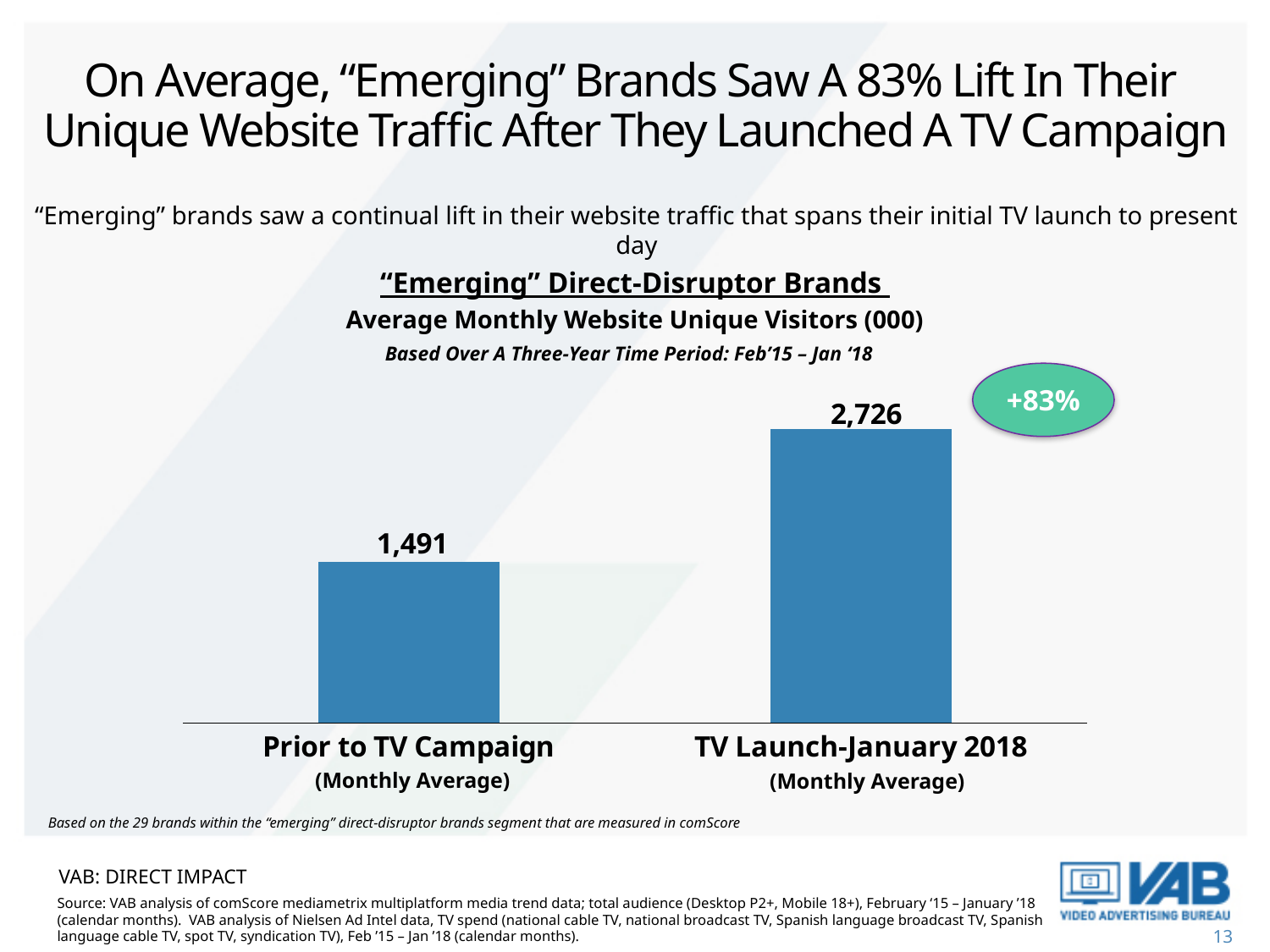
What is the difference between the TV Launch-January 2018 value and the Prior to TV Campaign value? 1,235 What is the average monthly website unique visitors (000) value for TV Launch-January 2018? 2,726 What is the average monthly website unique visitors (000) value for Prior to TV Campaign? 1,491 Do the values rise or fall from Prior to TV Campaign to TV Launch-January 2018? Rise What time period does the chart subtitle say the data is based over? Feb'15 – Jan '18 What kind of chart is shown on the slide? Bar chart Which category has the higher value, Prior to TV Campaign or TV Launch-January 2018? TV Launch-January 2018 What percentage lift is shown in the oval callout on the chart? +83% Which category has the lowest value on the chart? Prior to TV Campaign How many categories are shown on the chart? 2 Which category has the highest value on the chart? TV Launch-January 2018